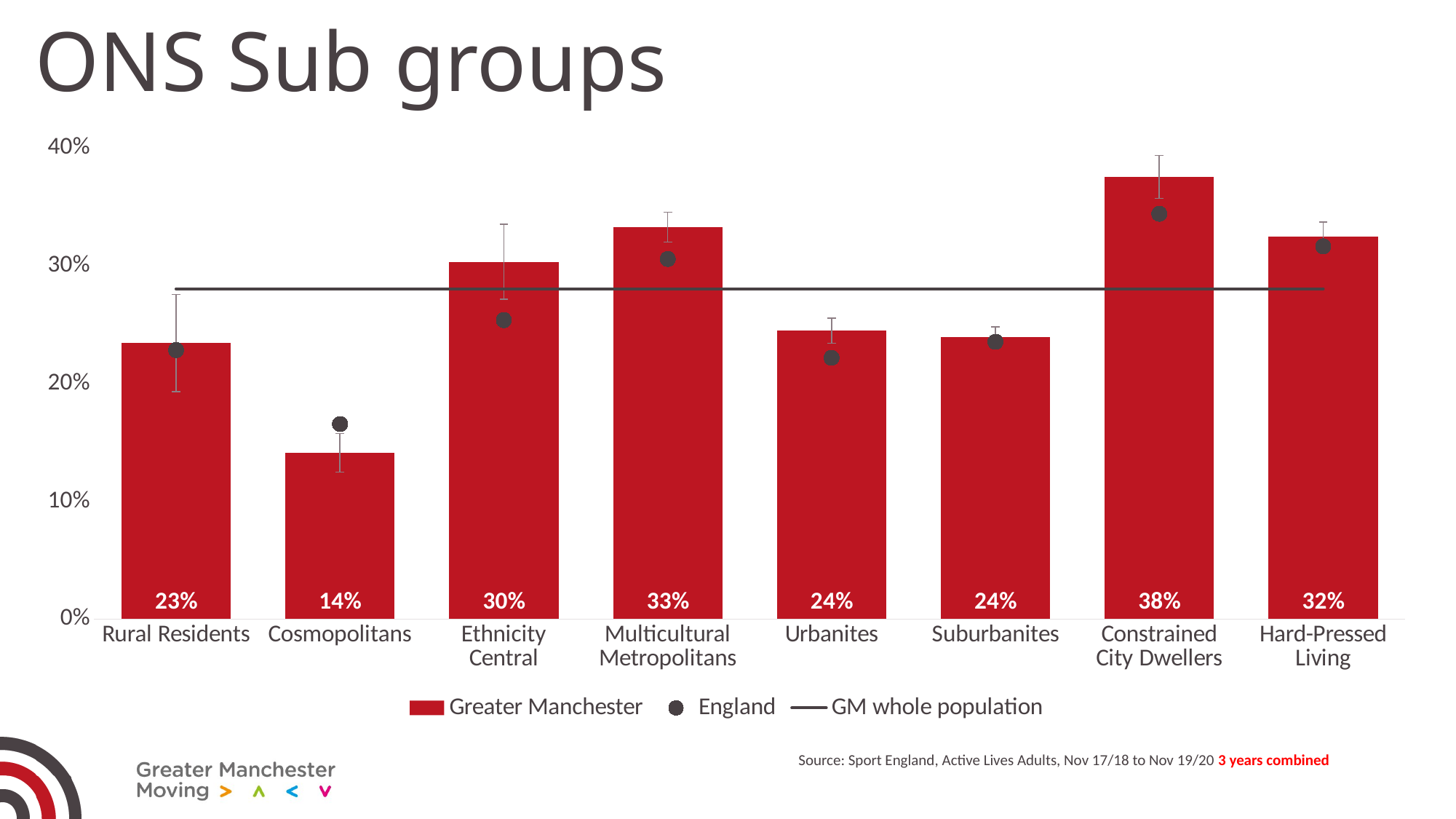
What is the difference between the Greater Manchester values for Constrained City Dwellers and Cosmopolitans? 24% Which ONS sub group has the lowest Greater Manchester value? Cosmopolitans What is the Greater Manchester value for Cosmopolitans? 14% Which ONS sub group has the highest Greater Manchester value? Constrained City Dwellers Is the England value for Cosmopolitans greater or less than 20%? less What is the Greater Manchester value for Multicultural Metropolitans? 33% How many series does the legend list? 3 Which has a larger Greater Manchester value, Ethnicity Central or Hard-Pressed Living? Hard-Pressed Living What is the Greater Manchester value for Constrained City Dwellers? 38% How many ONS sub groups are shown on the x axis? 8 What kind of chart is used to show the Greater Manchester values? Bar chart